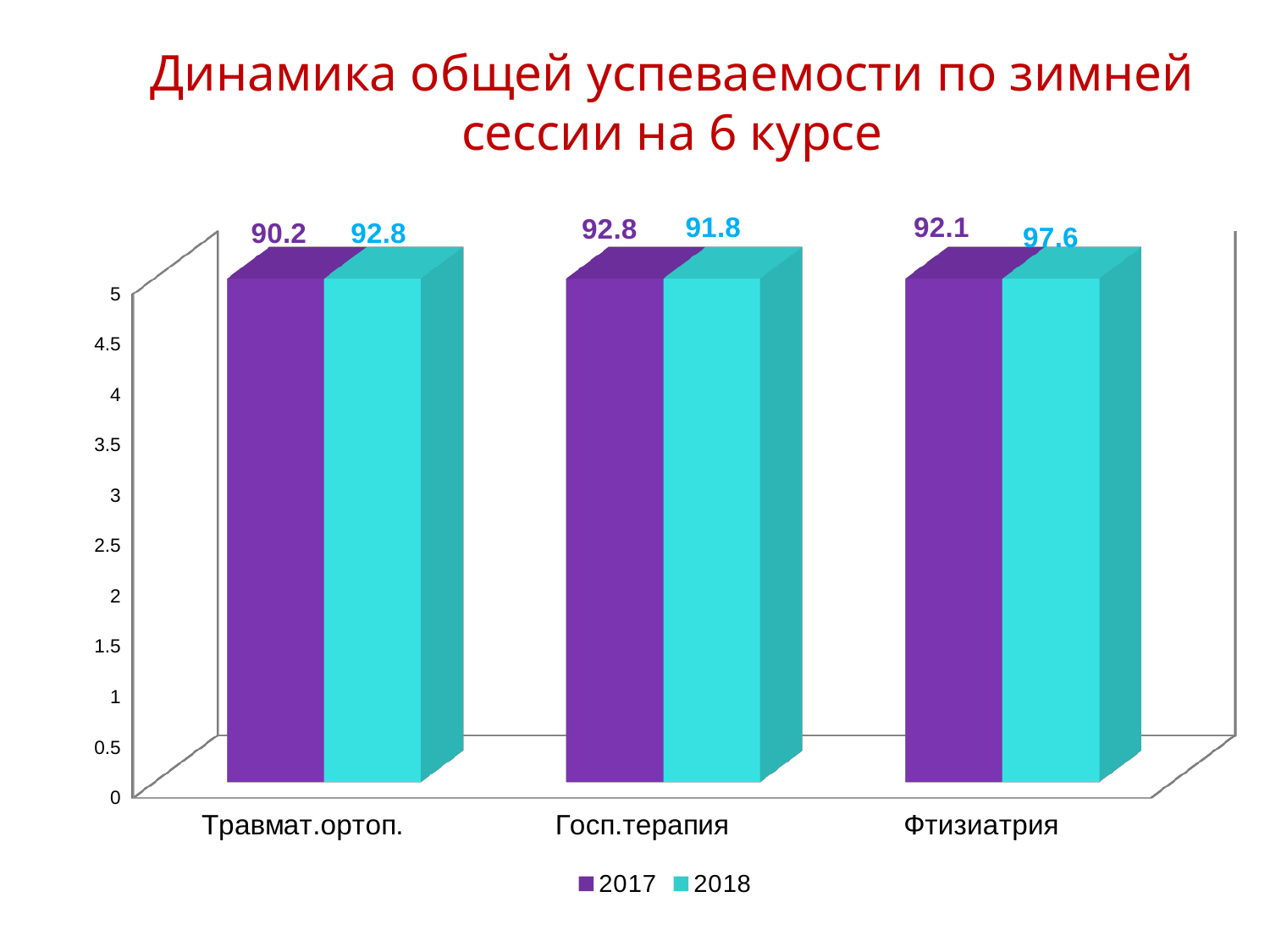
How many categories are shown on the x axis? 3 What is the value for Госп.терапия in the 2018 series? 91.8 What is the difference between the 2018 and 2017 values for Фтизиатрия? 5.5 What is the value for Травмат.ортоп. in the 2017 series? 90.2 What is the difference between the 2018 and 2017 values for Травмат.ортоп.? 2.6 What is the value for Фтизиатрия in the 2018 series? 97.6 For Госп.терапия, which series has the larger value, 2017 or 2018? 2017 Which category has the highest value in the 2018 series? Фтизиатрия Which category has the lowest value in the 2018 series? Госп.терапия Which category has the lowest value in the 2017 series? Травмат.ортоп. What kind of chart is shown on the slide? Bar chart How many series does the legend list? 2